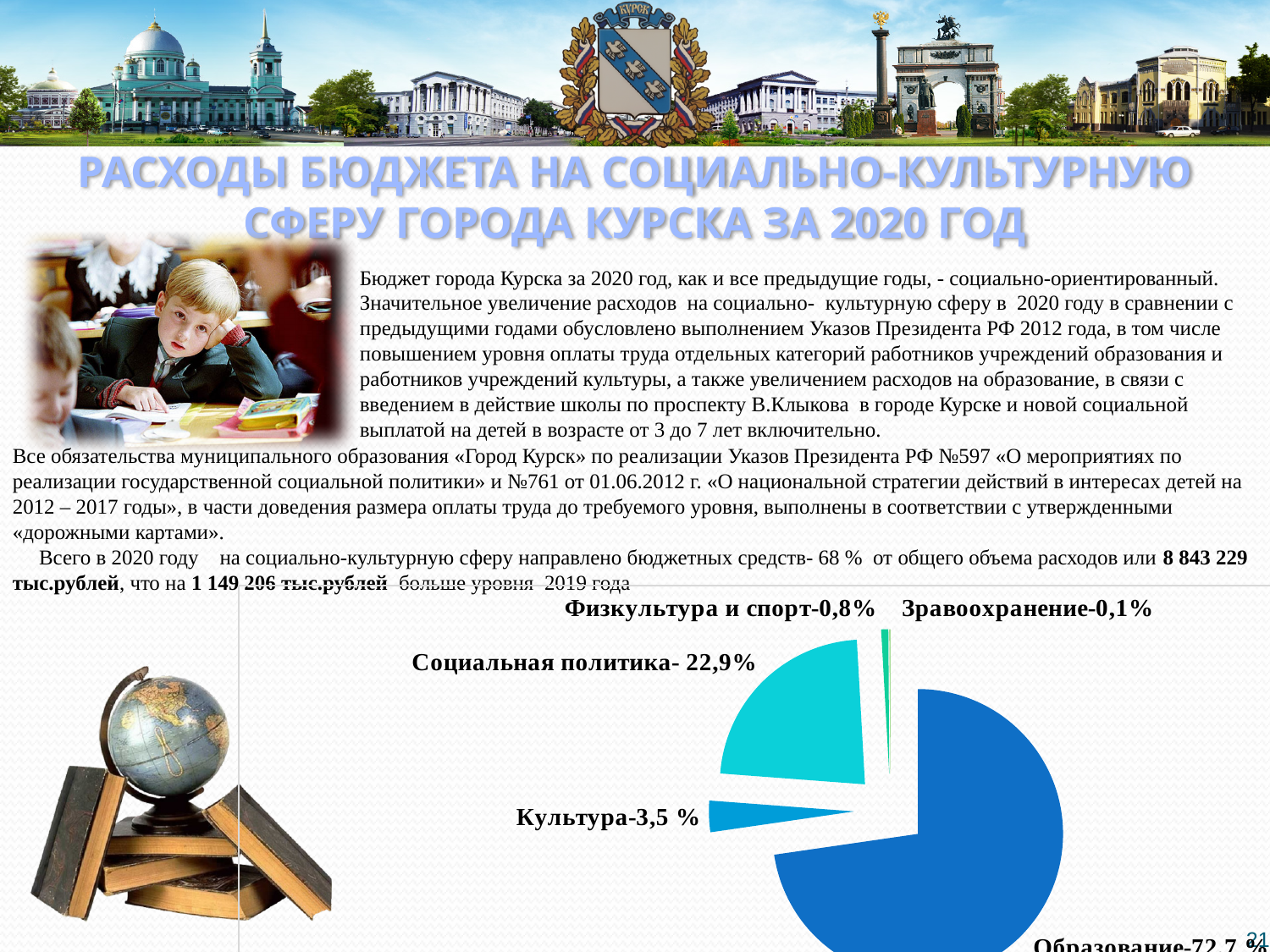
What kind of chart is shown on the slide? pie chart Which category has the smallest slice of the pie chart? Здравоохранение How many categories are shown in the pie chart? 5 What share of the pie chart does Здравоохранение have? 0,1% What colour is the Образование slice of the pie chart? blue What share of the pie chart does Физкультура и спорт have? 0,8% What share of the pie chart does Культура have? 3,5 % What is the difference in percentage points between Социальная политика and Культура in the pie chart? 19,4 Which category has the largest slice of the pie chart? Образование Which is larger in the pie chart: Социальная политика or Культура? Социальная политика What share of the pie chart does Образование have? 72,7 % What share of the pie chart does Социальная политика have? 22,9%